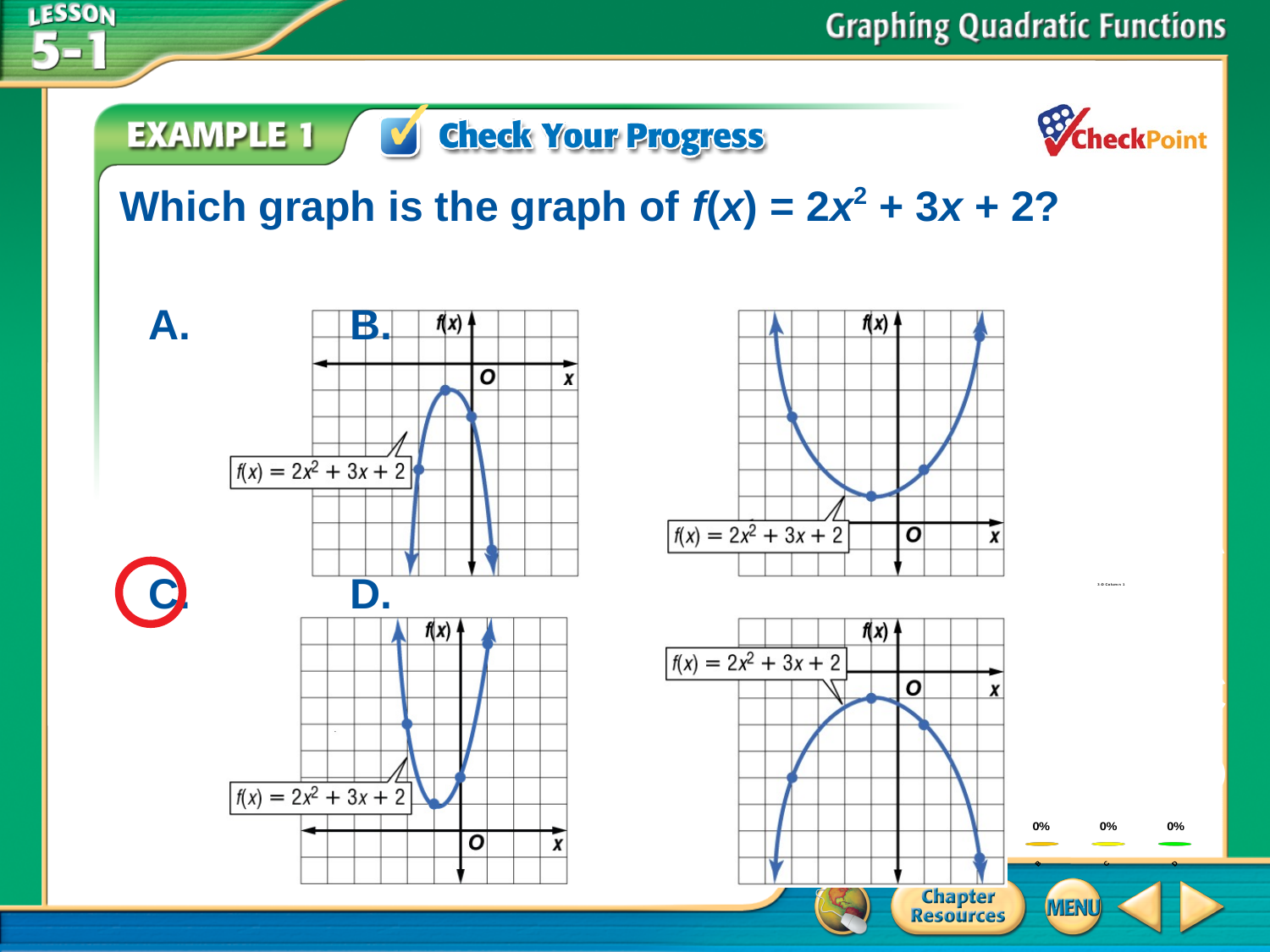
In graph B, does the parabola open upward or downward? upward How many graphs labeled with answer choices (A, B, C, D) are shown on the slide? 4 In graph C, does the parabola open upward or downward? upward How many bars are in the small bar chart in the bottom right corner of the slide? 3 What function is written in the label box on each of the four graphs? f(x) = 2x^2 + 3x + 2 What value is printed above each bar in the small bar chart in the bottom right corner? 0% In graph A, does the parabola open upward or downward? downward Which answer choice is circled in red on the slide? C What kind of chart is the small chart in the bottom right corner of the slide? bar chart